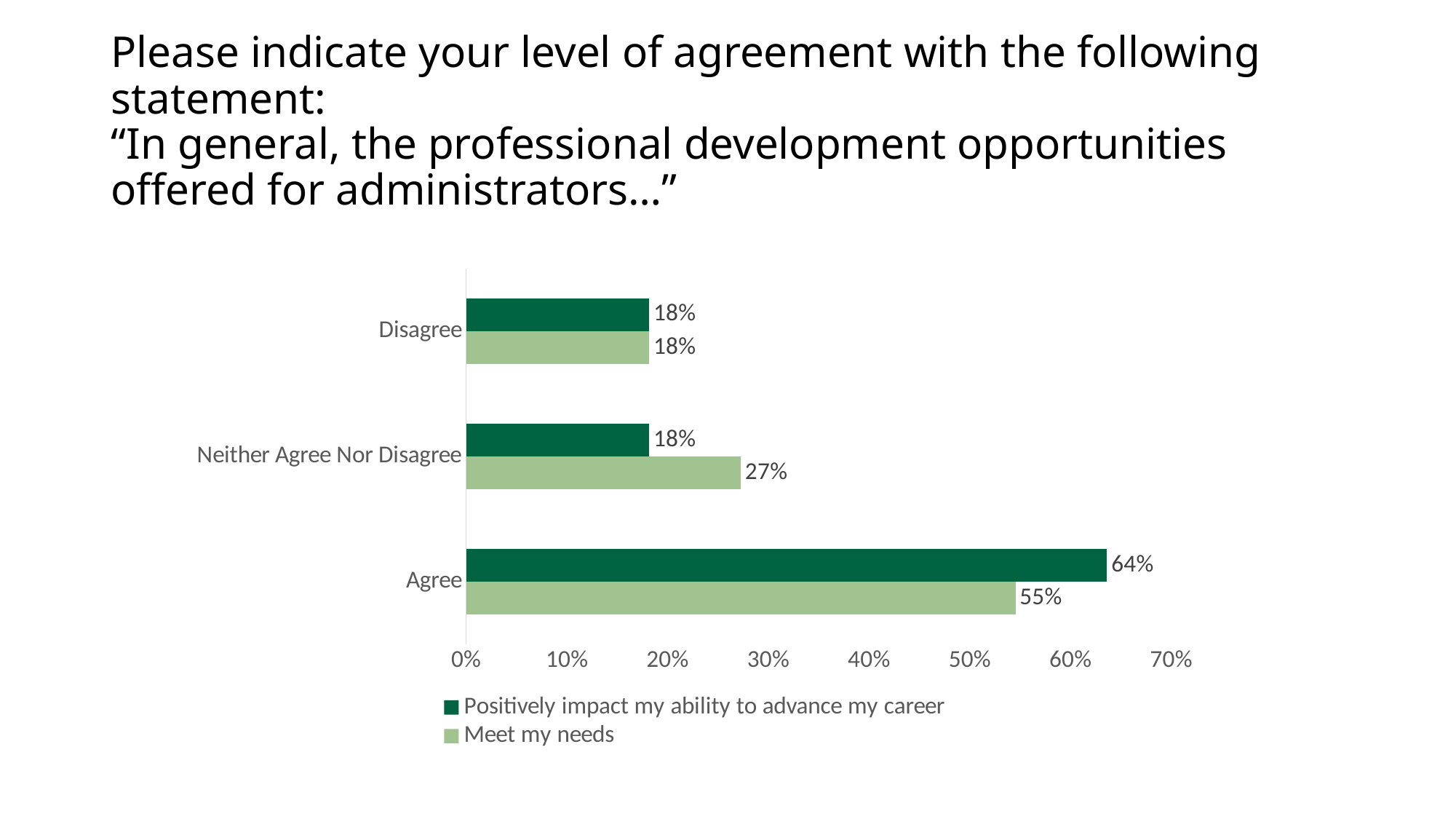
What is the value for 'Neither Agree Nor Disagree' in the 'Meet my needs' series? 27% What type of chart is shown on the slide? Bar chart What is the value for 'Disagree' in the 'Positively impact my ability to advance my career' series? 18% How many series does the legend list? 2 Which series is shown in the darker green colour? Positively impact my ability to advance my career What is the difference between the 'Agree' values for the two series? 9% What percentage of respondents agree that professional development opportunities positively impact their ability to advance their career? 64% What is the difference between the two series' values for 'Neither Agree Nor Disagree'? 9% For 'Neither Agree Nor Disagree', which series has the larger value? Meet my needs How many response categories are shown on the chart? 3 What percentage of respondents agree that professional development opportunities meet their needs? 55% Which response category has the highest value for the 'Meet my needs' series? Agree